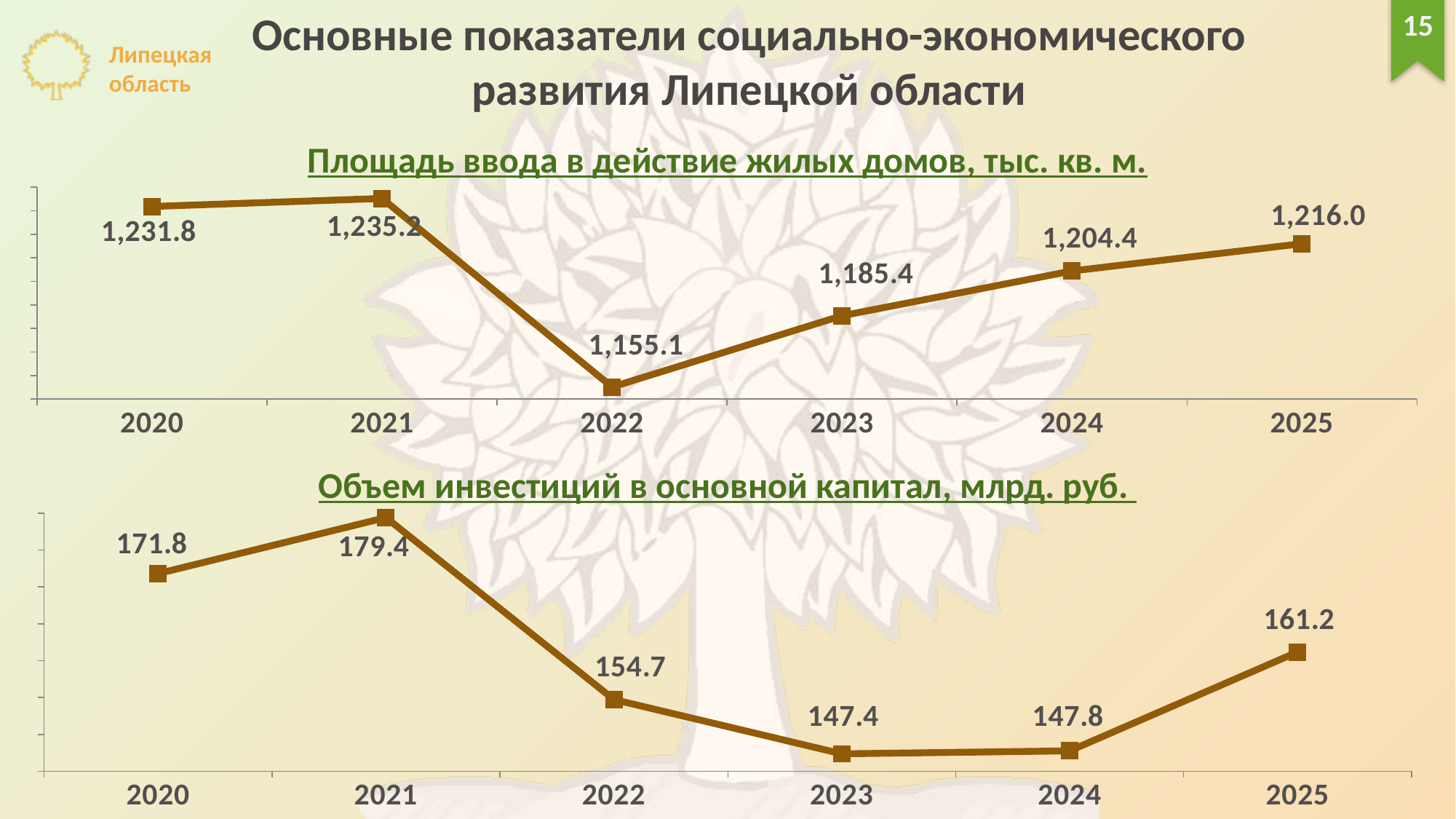
In the chart 'Объем инвестиций в основной капитал, млрд. руб.', which year has the lowest value? 2023 In the chart 'Площадь ввода в действие жилых домов, тыс. кв. м.', what is the difference between the 2025 value and the 2024 value? 11.6 In the chart 'Площадь ввода в действие жилых домов, тыс. кв. м.', which year has the lowest value? 2022 In the chart 'Объем инвестиций в основной капитал, млрд. руб.', which is larger, the value for 2020 or the value for 2022? 2020 In the chart 'Объем инвестиций в основной капитал, млрд. руб.', what is the value for 2021? 179.4 In the chart 'Площадь ввода в действие жилых домов, тыс. кв. м.', what is the value for 2022? 1,155.1 In the chart 'Площадь ввода в действие жилых домов, тыс. кв. м.', how many data points are plotted? 6 In the chart 'Площадь ввода в действие жилых домов, тыс. кв. м.', which year has the highest value? 2021 In the chart 'Объем инвестиций в основной капитал, млрд. руб.', what is the value for 2025? 161.2 What type of chart is used for 'Объем инвестиций в основной капитал, млрд. руб.'? line chart In the chart 'Объем инвестиций в основной капитал, млрд. руб.', what is the difference between the 2021 value and the 2023 value? 32.0 In the chart 'Площадь ввода в действие жилых домов, тыс. кв. м.', do the values rise or fall from 2022 to 2025? rise